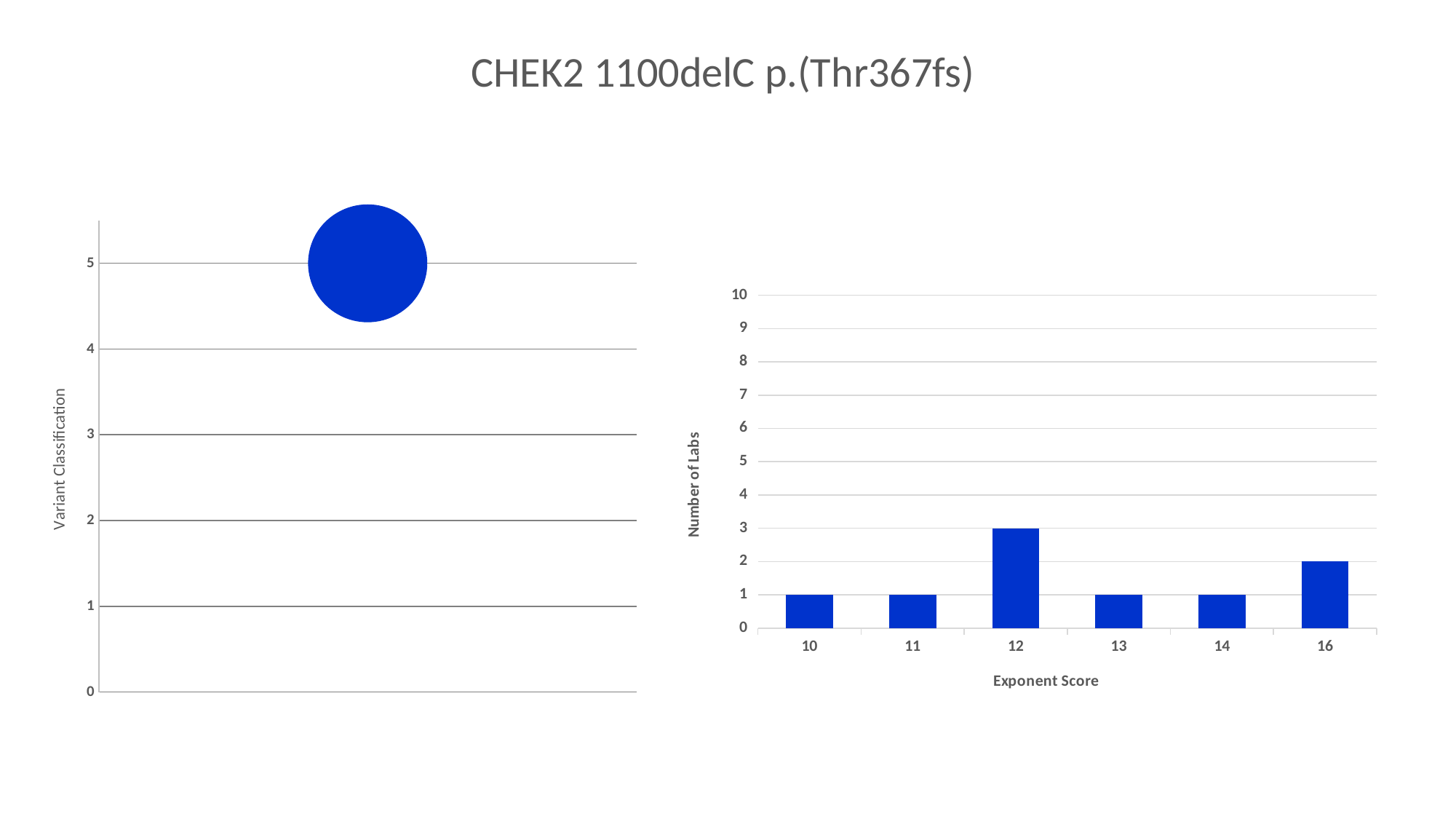
On the right-hand chart, how many Exponent Score categories are shown on the x axis? 6 On the right-hand chart, what is the label of the x axis? Exponent Score On the right-hand chart, how many labs reported an Exponent Score of 12? 3 On the right-hand chart, which Exponent Score has the highest number of labs? 12 On the left-hand chart, at what Variant Classification value is the bubble plotted? 5 On the right-hand chart, which has more labs: Exponent Score 16 or Exponent Score 14? 16 On the right-hand chart, is the number of labs for Exponent Score 12 greater or less than 5? less What is the title of the slide? CHEK2 1100delC p.(Thr367fs) On the right-hand chart, what is the difference in number of labs between Exponent Score 12 and Exponent Score 16? 1 On the right-hand chart, how many labs reported an Exponent Score of 16? 2 What kind of chart is the right-hand chart? bar chart On the right-hand chart, how many labs reported an Exponent Score of 10? 1